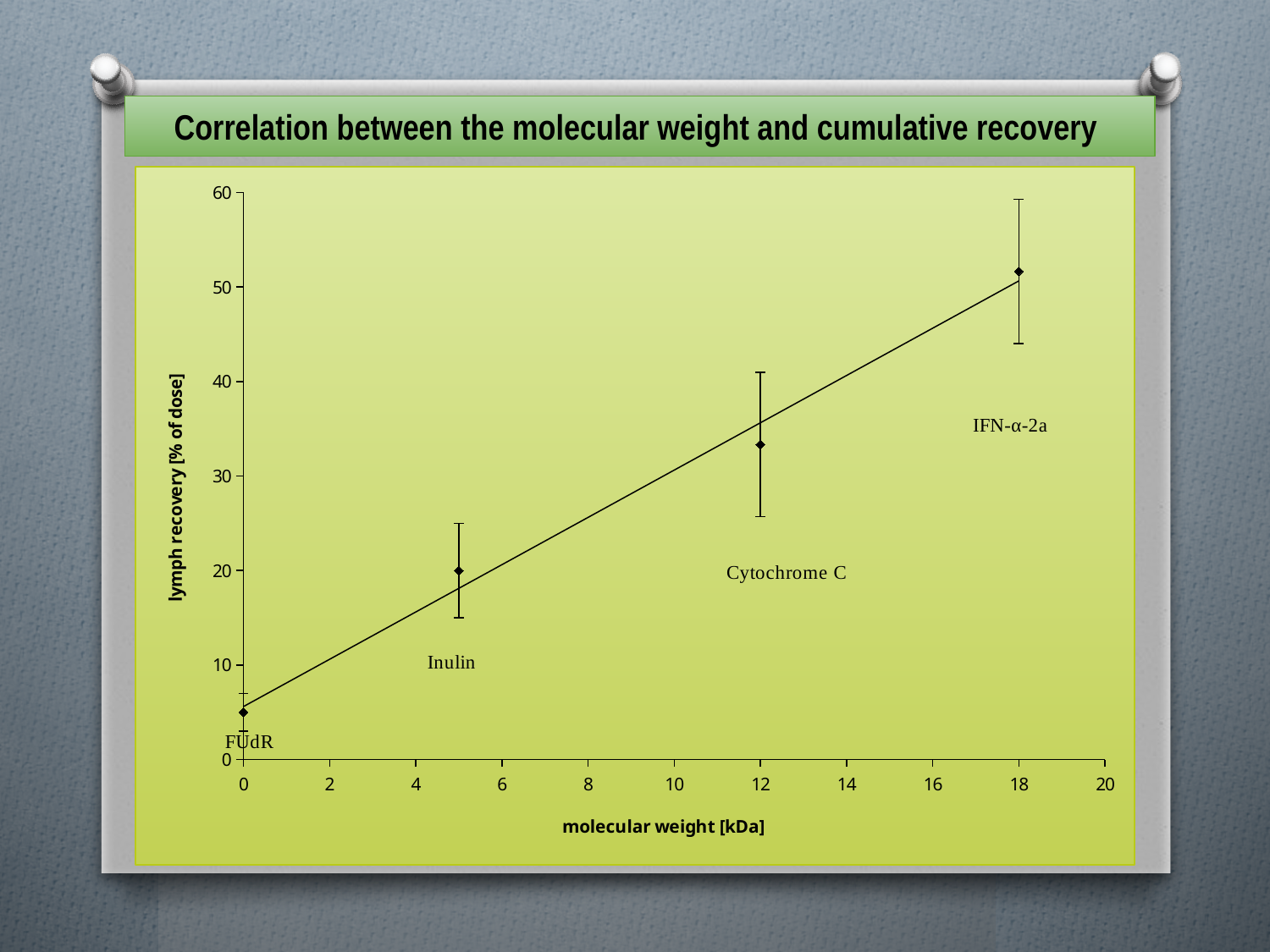
At what molecular weight in kDa is the Cytochrome C point plotted? 12 Does lymph recovery rise or fall as molecular weight increases? rise Is the lymph recovery for Cytochrome C greater or less than 30? greater Which has a higher lymph recovery, Inulin or Cytochrome C? Cytochrome C What kind of chart is shown on the slide? scatter chart How many data points are plotted on the chart? 4 Is the lymph recovery for FUdR greater or less than 10? less Is the lymph recovery for IFN-α-2a greater or less than 40? greater What is the label of the y axis? lymph recovery [% of dose] Which compound has the highest lymph recovery? IFN-α-2a What is the title of the chart? Correlation between the molecular weight and cumulative recovery Which compound has the lowest lymph recovery? FUdR